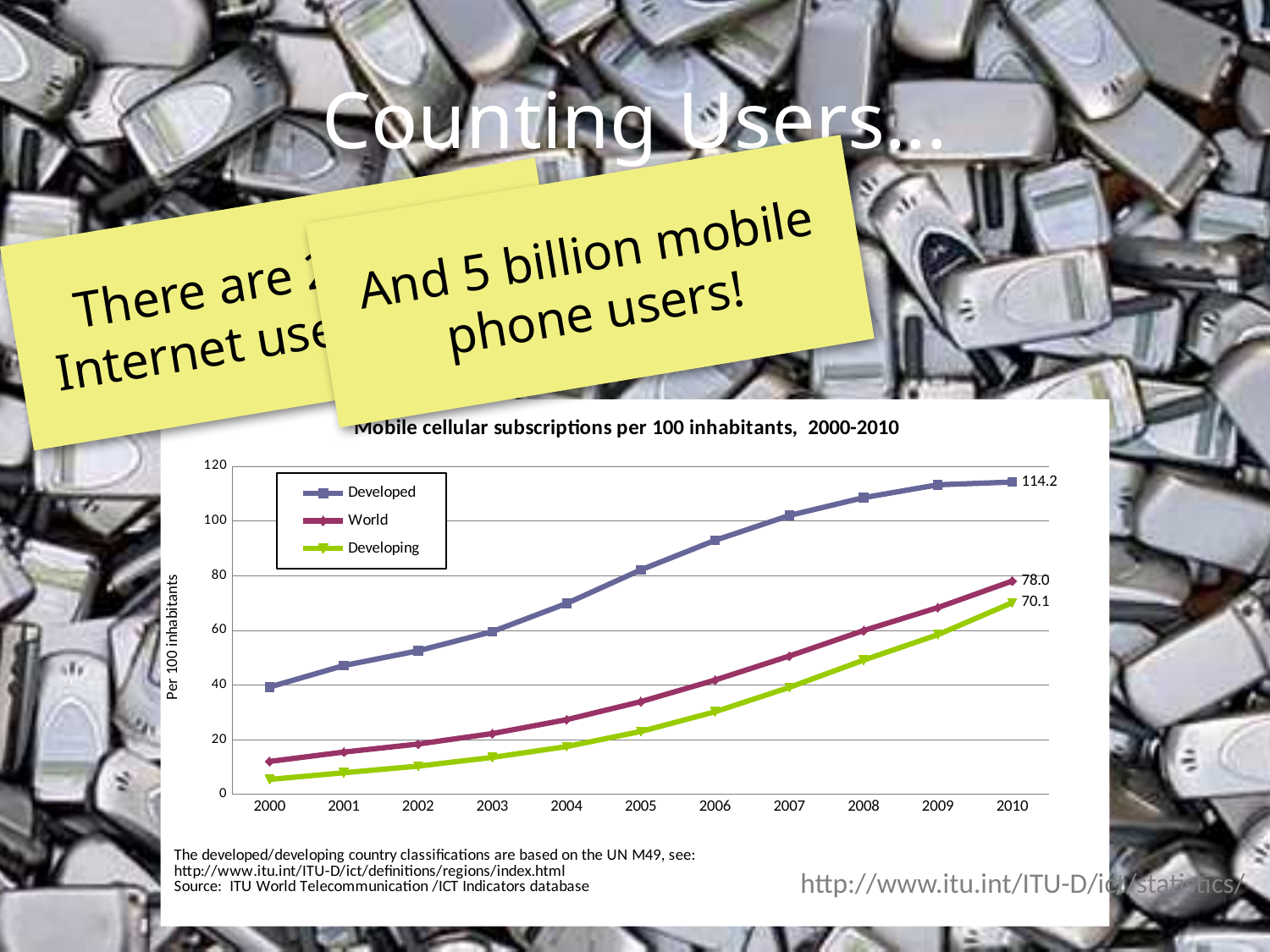
Is the value for Developed in 2004 greater or less than 60? greater Which series has the highest value in 2010? Developed What kind of chart is shown on the slide? line chart What is the value for Developing in 2010? 70.1 Does the Developed series rise or fall from 2000 to 2010? rise What is the value for Developed in 2010? 114.2 How many series does the legend of the chart list? 3 What is the difference between the World and Developing values in 2010? 7.9 How many years are shown on the x axis of the chart? 11 Is the value for Developing in 2000 greater or less than 20? less What is the value for World in 2010? 78.0 What is the difference between the Developed and World values in 2010? 36.2